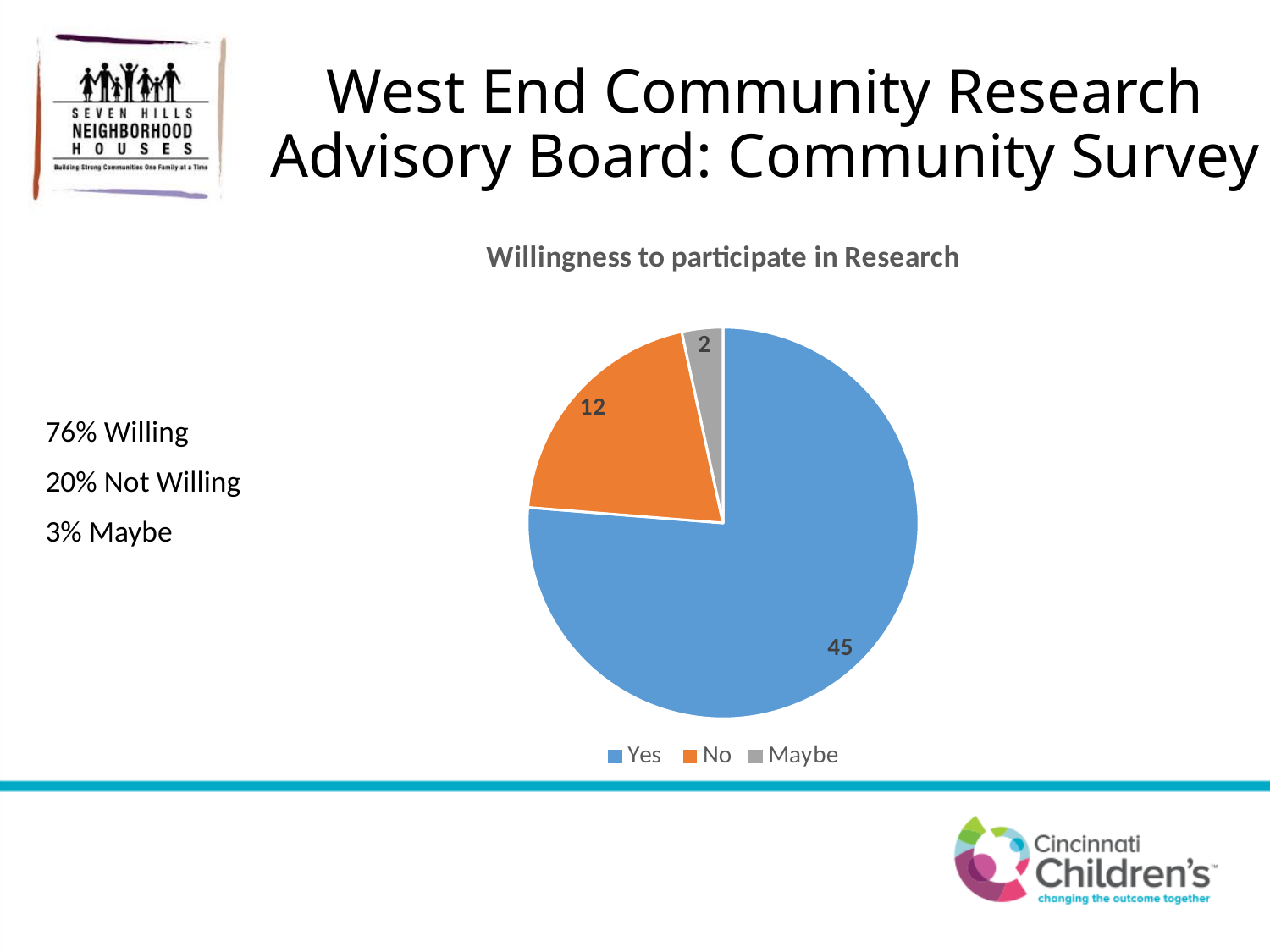
What is the value for the Maybe slice? 2 What is the total of all slices in the pie chart? 59 What is the title of the chart? Willingness to participate in Research What is the difference between the Yes and No values? 33 What type of chart is shown on the slide? Pie chart Which category has the smallest slice? Maybe Which is larger, the No slice or the Maybe slice? No Which category has the largest slice? Yes What is the value for the No slice? 12 What colour is the Yes slice? Blue What is the value for the Yes slice? 45 How many categories does the pie chart have? 3